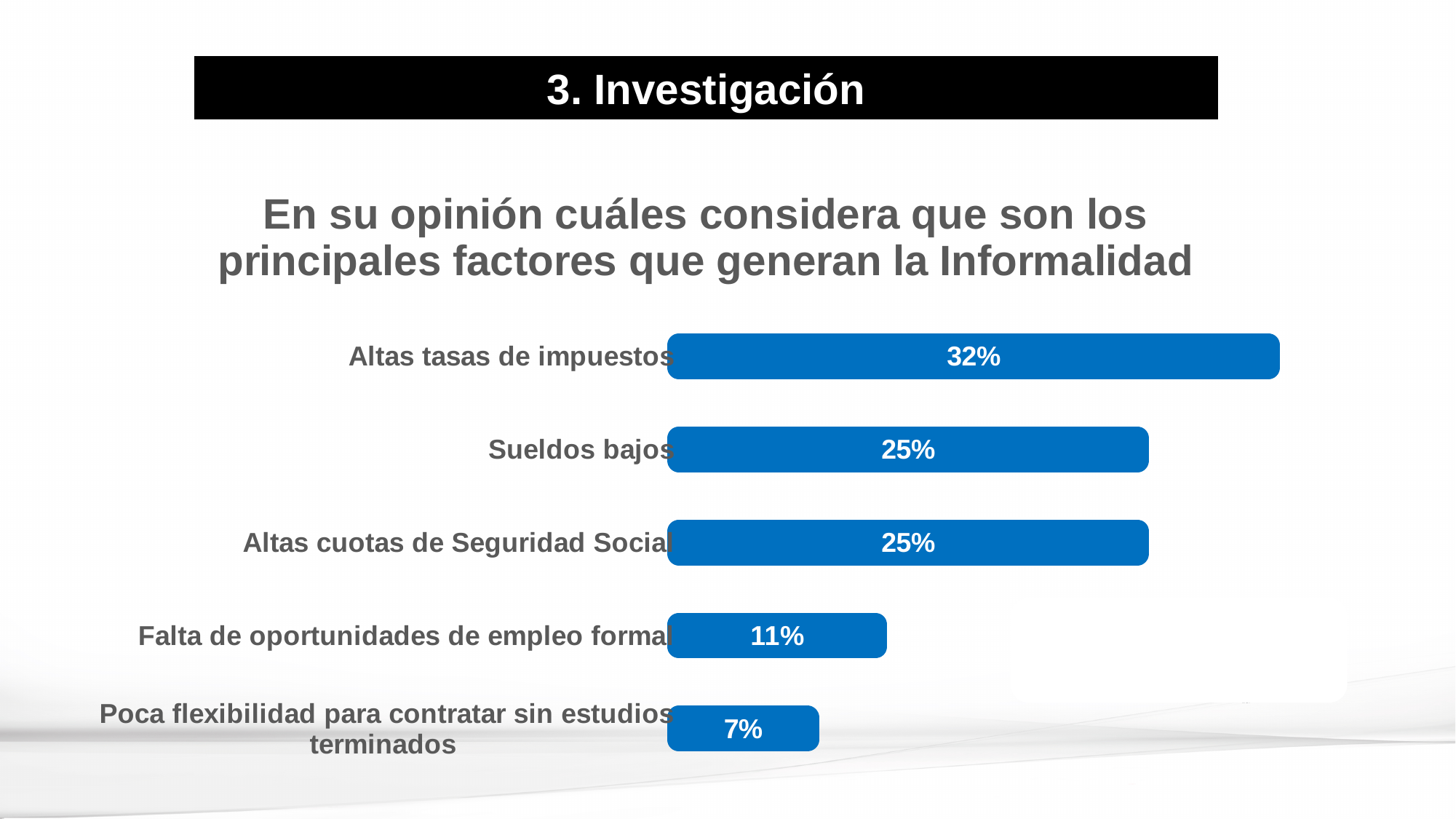
What is the value for Falta de oportunidades de empleo formal? 11% Which category has the lowest value? Poca flexibilidad para contratar sin estudios terminados What kind of chart is shown on the slide? Bar chart Which category has the highest value? Altas tasas de impuestos What is the difference between the values for Falta de oportunidades de empleo formal and Poca flexibilidad para contratar sin estudios terminados? 4% What is the title of the chart? En su opinión cuáles considera que son los principales factores que generan la Informalidad What is the value for Altas tasas de impuestos? 32% How many categories are shown in the chart? 5 Which is larger, the value for Altas cuotas de Seguridad Social or the value for Falta de oportunidades de empleo formal? Altas cuotas de Seguridad Social What is the value for Sueldos bajos? 25% What is the value for Poca flexibilidad para contratar sin estudios terminados? 7% What is the difference between the values for Altas tasas de impuestos and Sueldos bajos? 7%